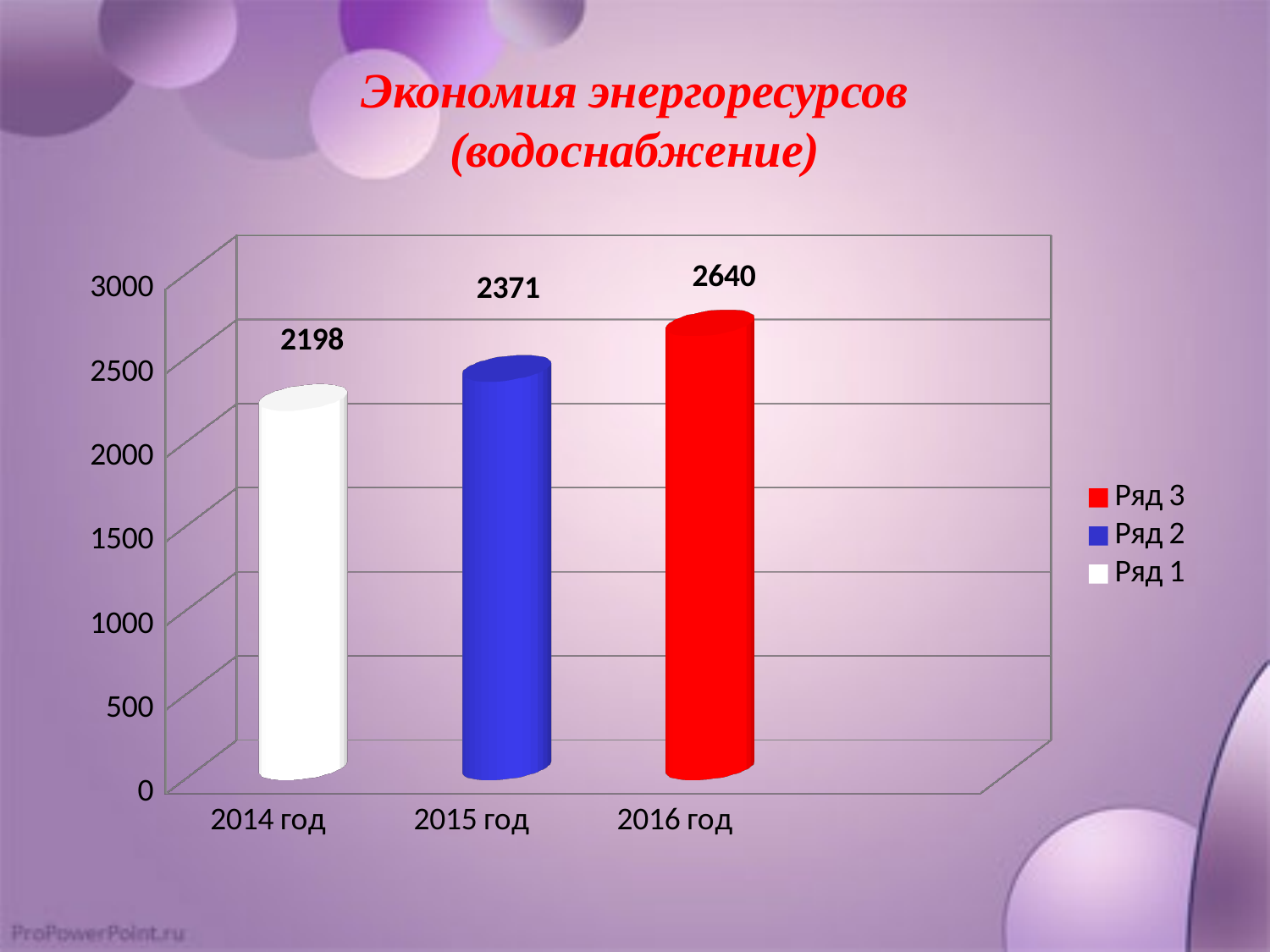
How many years are shown on the x axis? 3 What is the difference between the values for 2015 год and 2014 год? 173 Which is larger, the value for 2015 год or the value for 2016 год? 2016 год Do the values rise or fall from 2014 год to 2016 год? rise How many series does the legend list? 3 What is the value for 2016 год? 2640 What is the value for 2014 год? 2198 What is the value for 2015 год? 2371 Which year has the lowest value? 2014 год What is the difference between the values for 2016 год and 2014 год? 442 Which year has the highest value? 2016 год Is the value for 2016 год greater or less than 2500? greater